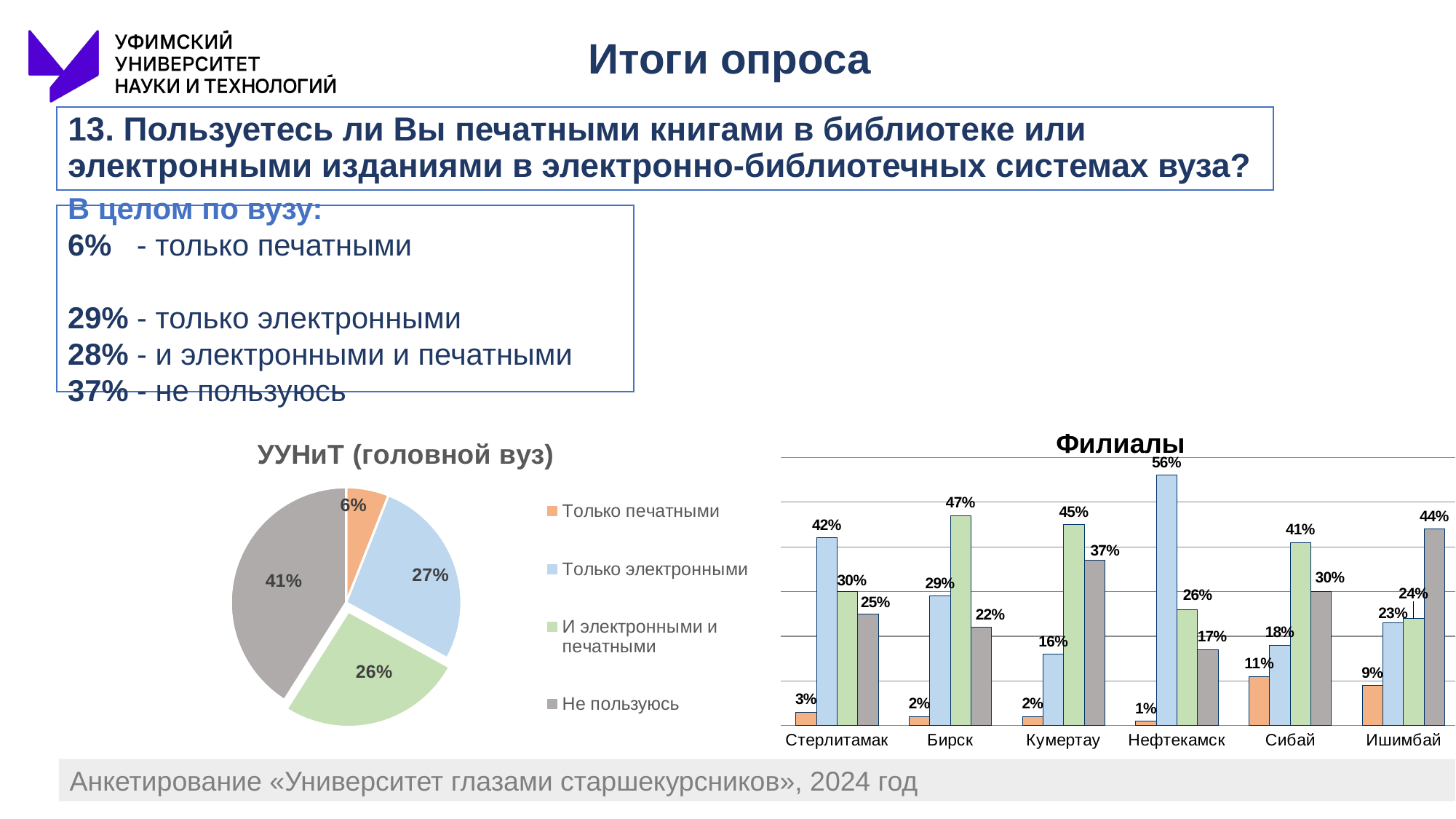
In the pie chart 'УУНиТ (головной вуз)', what share is labelled for 'Не пользуюсь'? 41% In the pie chart 'УУНиТ (головной вуз)', what is the difference between 'Не пользуюсь' and 'И электронными и печатными'? 15% In the bar chart 'Филиалы', what is the value of the light blue bar ('Только электронными') for Нефтекамск? 56% In the bar chart 'Филиалы', what is the difference between the green bar ('И электронными и печатными') for Бирск and for Кумертау? 2% In the pie chart 'УУНиТ (головной вуз)', which category has the smallest slice? Только печатными What is the title of the pie chart on the left of the slide? УУНиТ (головной вуз) In the pie chart 'УУНиТ (головной вуз)', what is the value for 'Только электронными'? 27% What kind of chart is the one titled 'Филиалы'? Bar chart In the bar chart 'Филиалы', which is larger for Ишимбай: the grey bar ('Не пользуюсь') or the light blue bar ('Только электронными')? Не пользуюсь In the bar chart 'Филиалы', how many branches (categories) are shown on the x axis? 6 In the bar chart 'Филиалы', which branch has the highest value for the orange bar ('Только печатными')? Сибай How many entries does the legend next to the pie chart 'УУНиТ (головной вуз)' list? 4